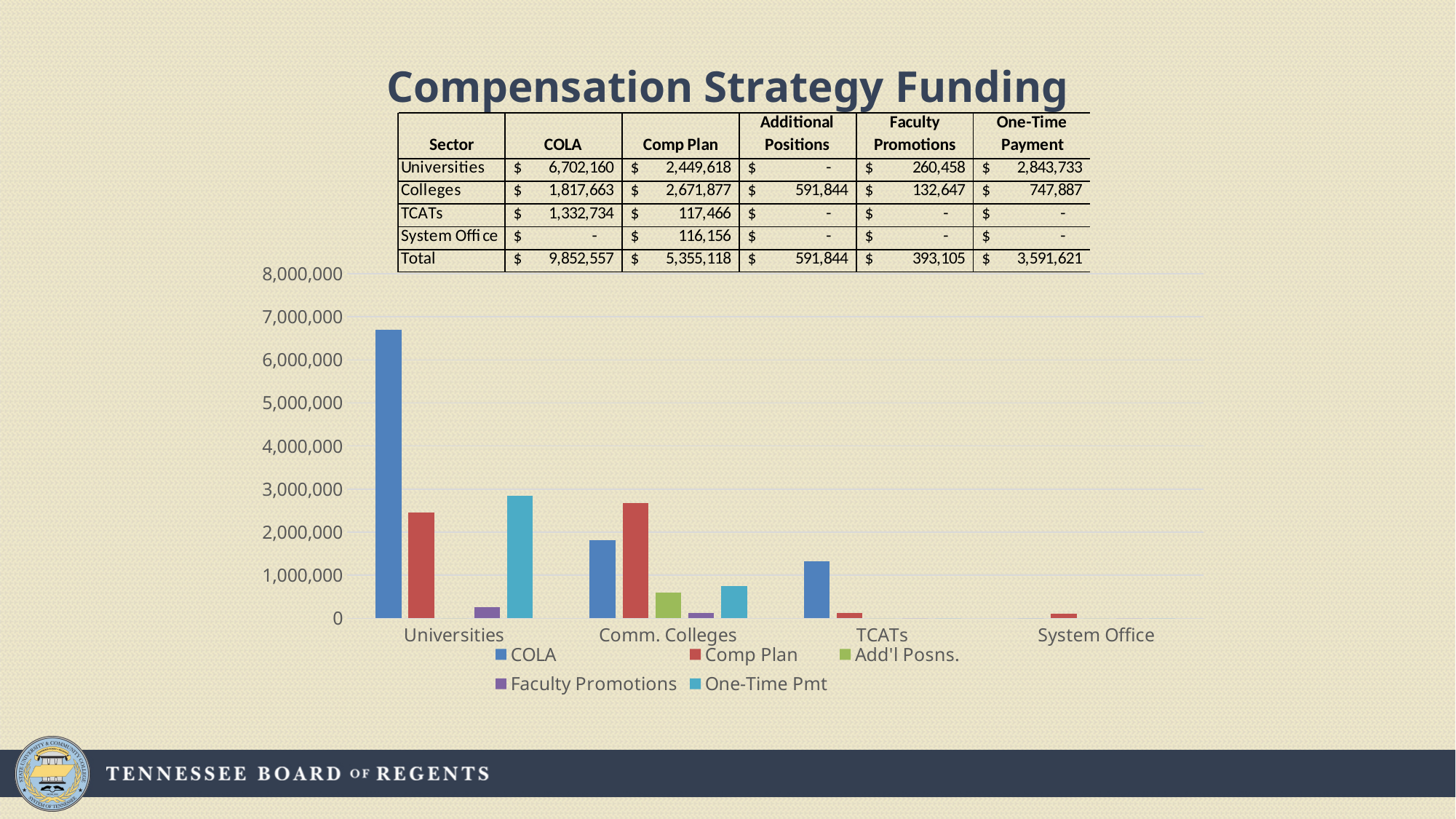
Is the Comp Plan value for Comm. Colleges greater or less than 2,000,000? greater Which sector has the highest COLA bar in the chart? Universities How many series does the chart legend list? 5 For Universities, which is larger: the COLA bar or the Comp Plan bar? COLA According to the table, what is the Total COLA amount? $9,852,557 Using the table values, what is the difference between the COLA amount for Universities and the COLA amount for Colleges? $4,884,497 What kind of chart is shown on the slide? bar chart How many sector categories are shown on the x axis of the chart? 4 Is the COLA value for Universities greater or less than 6,000,000? greater Do the COLA bars rise or fall moving from Universities to System Office along the x axis? fall According to the table, what is the Additional Positions amount for Colleges? $591,844 For Comm. Colleges, which is larger: the COLA bar or the Comp Plan bar? Comp Plan